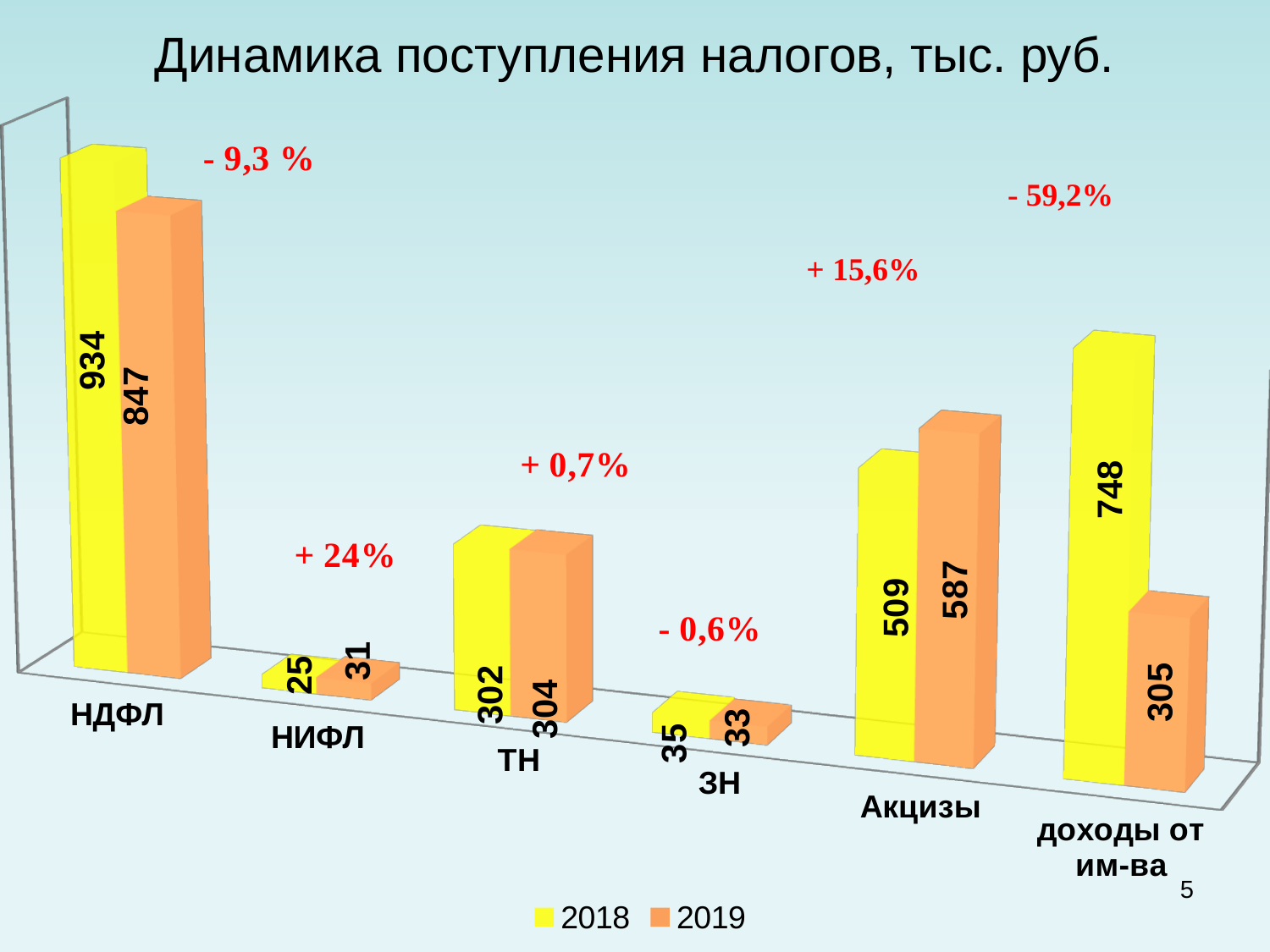
What is the difference between the 2018 and 2019 values for НДФЛ? 87 How many series does the legend list? 2 What is the 2019 value for Акцизы? 587 What kind of chart is shown on the slide? bar chart What is the 2018 value for НДФЛ? 934 Which is larger for Акцизы, the 2018 value or the 2019 value? 2019 What is the difference between the 2018 and 2019 values for доходы от им-ва? 443 Which category has the highest 2018 value? НДФЛ Which category has the lowest 2019 value? НИФЛ What percentage change is annotated above the доходы от им-ва bars? - 59,2% How many categories are shown on the x axis? 6 What is the 2019 value for доходы от им-ва? 305